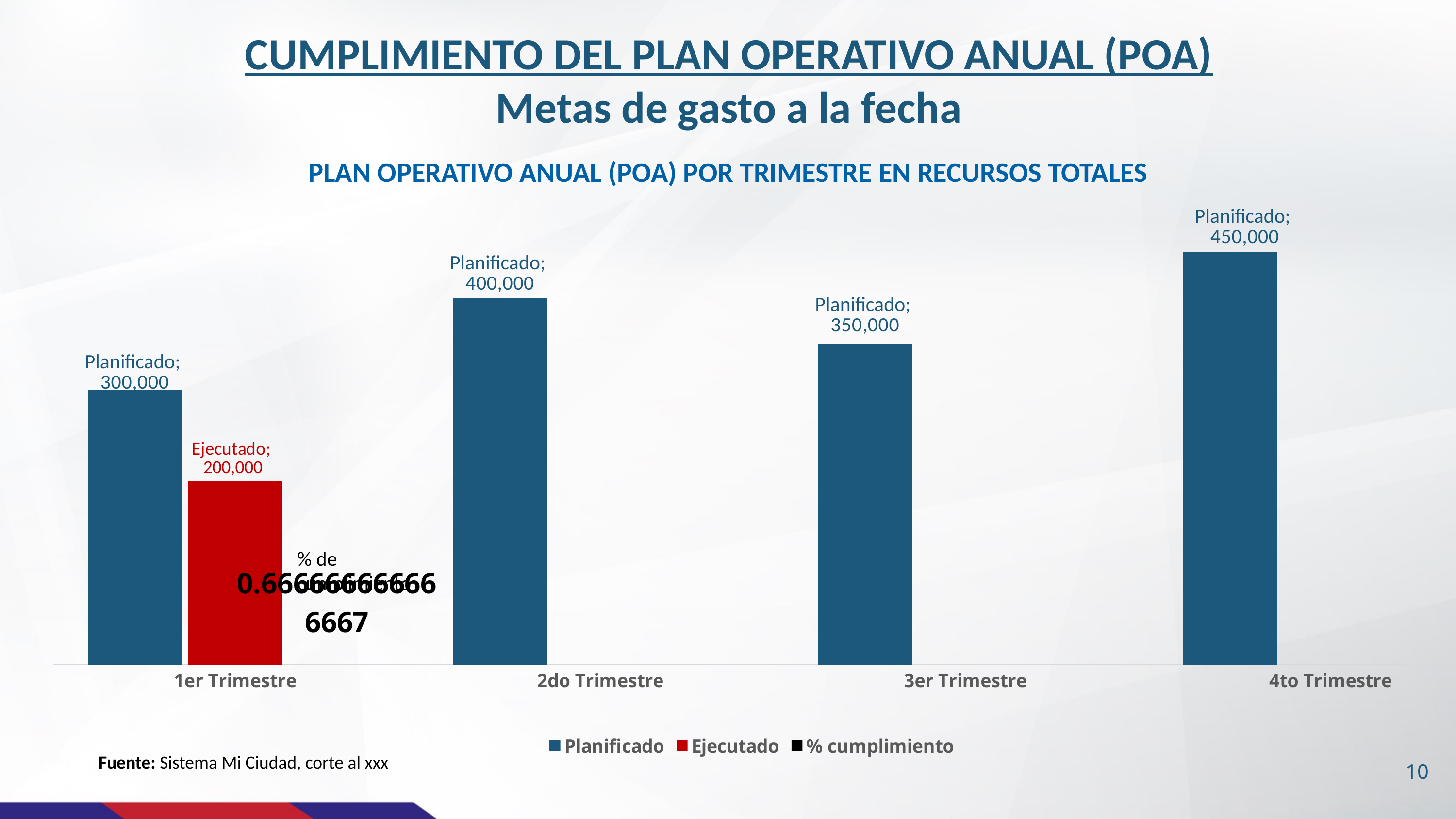
Which is larger, the Planificado value for 2do Trimestre or for 3er Trimestre? 2do Trimestre What kind of chart is shown on the slide? Bar chart What is the Planificado value for 3er Trimestre? 350,000 What is the Planificado value for 2do Trimestre? 400,000 How many series does the legend list? 3 How many quarters are shown on the x axis? 4 What is the Planificado value for 1er Trimestre? 300,000 What is the difference between the Planificado and Ejecutado values for 1er Trimestre? 100,000 What is the Ejecutado value for 1er Trimestre? 200,000 Which quarter has the highest Planificado value? 4to Trimestre Which quarter has the lowest Planificado value? 1er Trimestre What is the Planificado value for 4to Trimestre? 450,000